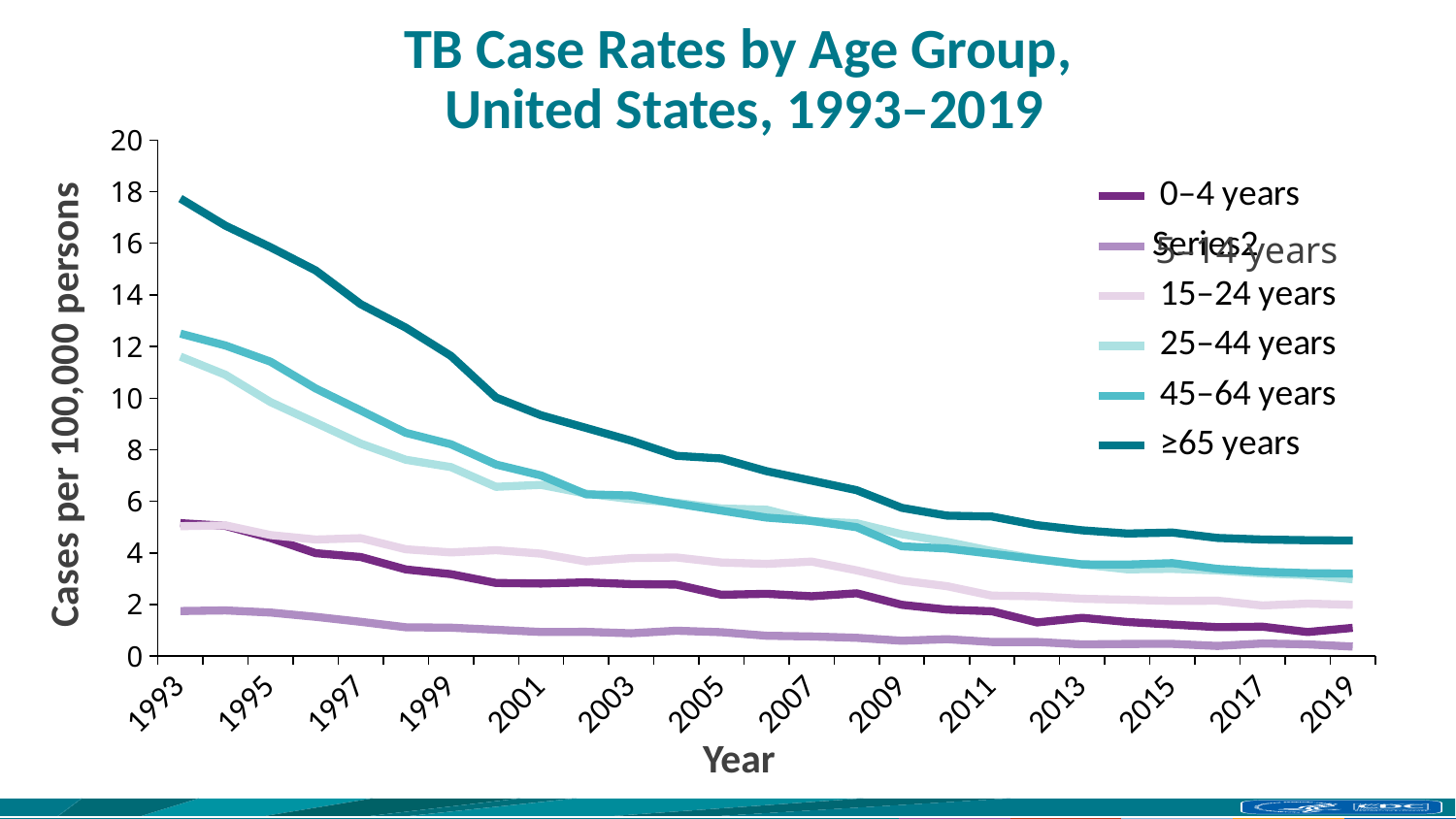
What is the title of the chart? TB Case Rates by Age Group, United States, 1993–2019 In 2019, which is larger: the value for 15–24 years or the value for 0–4 years? 15–24 years Which age group has the highest TB case rate in 2019? ≥65 years Is the value for 0–4 years in 2019 greater or less than 2? less Is the value for ≥65 years in 1993 greater or less than 16? greater Does the TB case rate for ≥65 years rise or fall from 1993 to 2019? fall What kind of chart is shown on the slide? line chart Which age group has the highest TB case rate in 1993? ≥65 years What is the label of the y axis? Cases per 100,000 persons Is the value for 45–64 years in 1993 greater or less than 10? greater How many series does the legend list? 6